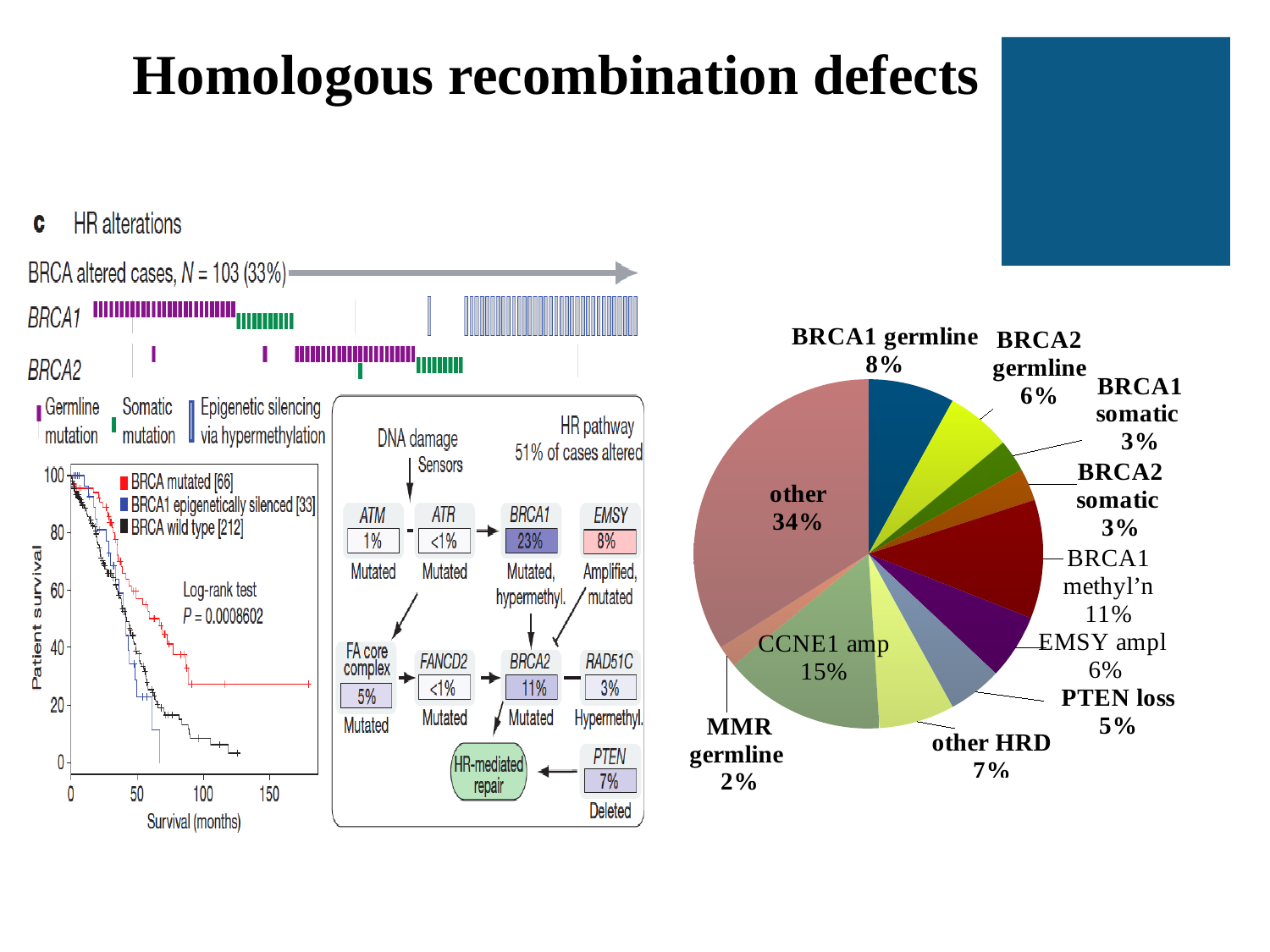
In the patient survival chart on the left, what is the label on the x axis? Survival (months) In the pie chart on the right, what share is labelled for BRCA1 methyl'n? 11% In the pie chart on the right, what share is labelled for CCNE1 amp? 15% How many slices does the pie chart on the right have? 11 In the pie chart on the right, which slice has the smallest share? MMR germline In the pie chart on the right, what is the combined share of BRCA1 somatic and BRCA2 somatic? 6% How many series does the legend of the patient survival chart on the left list? 3 In the pie chart on the right, what is the difference in percentage points between BRCA1 germline and BRCA2 germline? 2 In the pie chart on the right, what share is labelled for MMR germline? 2% In the pie chart on the right, which is larger, PTEN loss or other HRD? other HRD What kind of chart is shown on the right side of the slide? pie chart In the pie chart on the right, which slice has the largest share? other